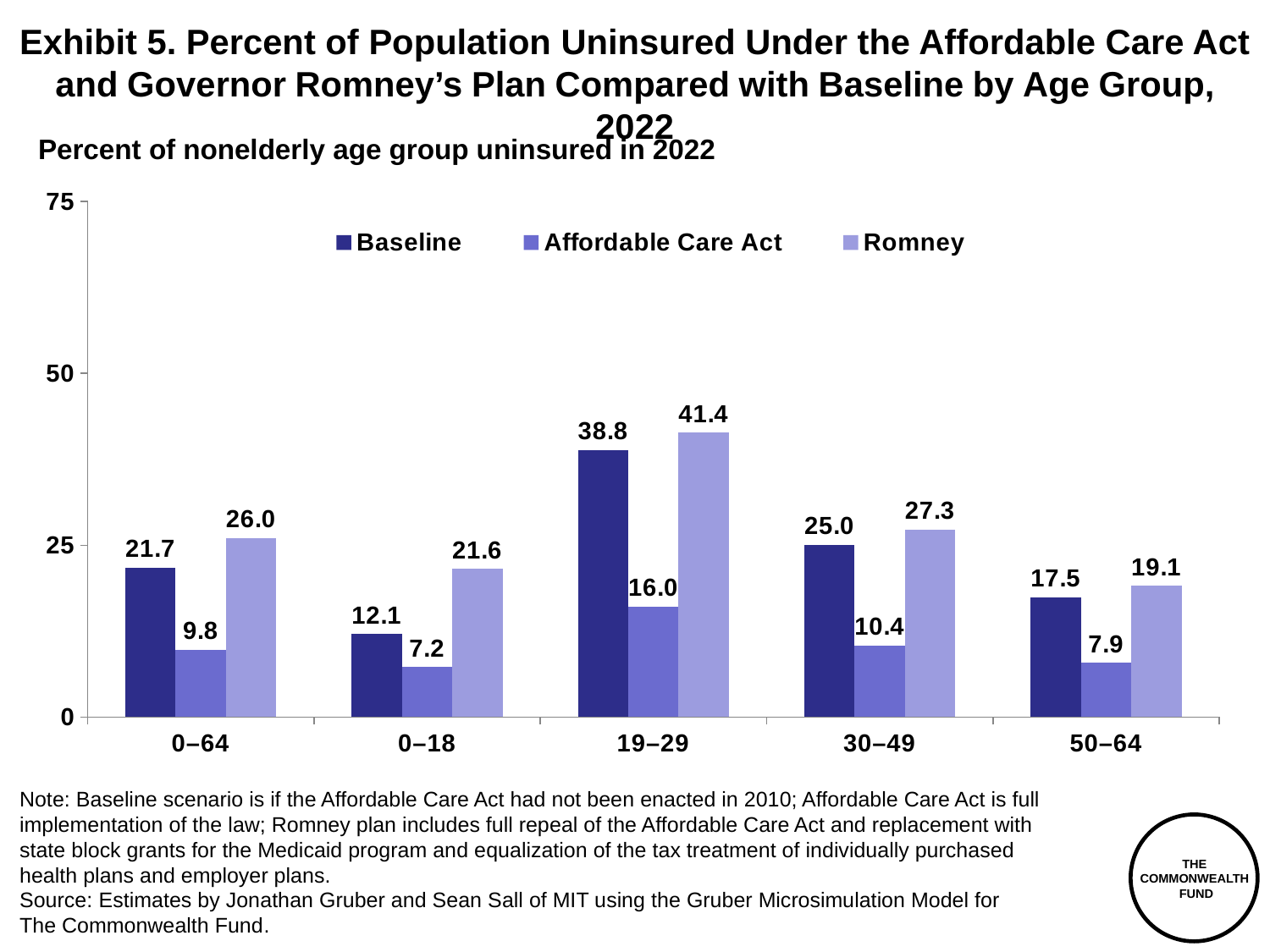
Which is larger for the 0–64 age group, the Baseline value or the Romney value? Romney What is the Baseline value for the 19–29 age group? 38.8 Which age group has the lowest Affordable Care Act value? 0–18 Is the Baseline value for the 19–29 age group greater or less than 25? greater Which age group has the highest Romney value? 19–29 What is the Romney value for the 0–18 age group? 21.6 How many age groups are shown on the x axis? 5 What is the Affordable Care Act value for the 50–64 age group? 7.9 What is the difference between the Romney and Affordable Care Act values for the 30–49 age group? 16.9 What kind of chart is shown on the slide? bar chart How many series does the legend list? 3 What are the three series listed in the legend? Baseline, Affordable Care Act, Romney